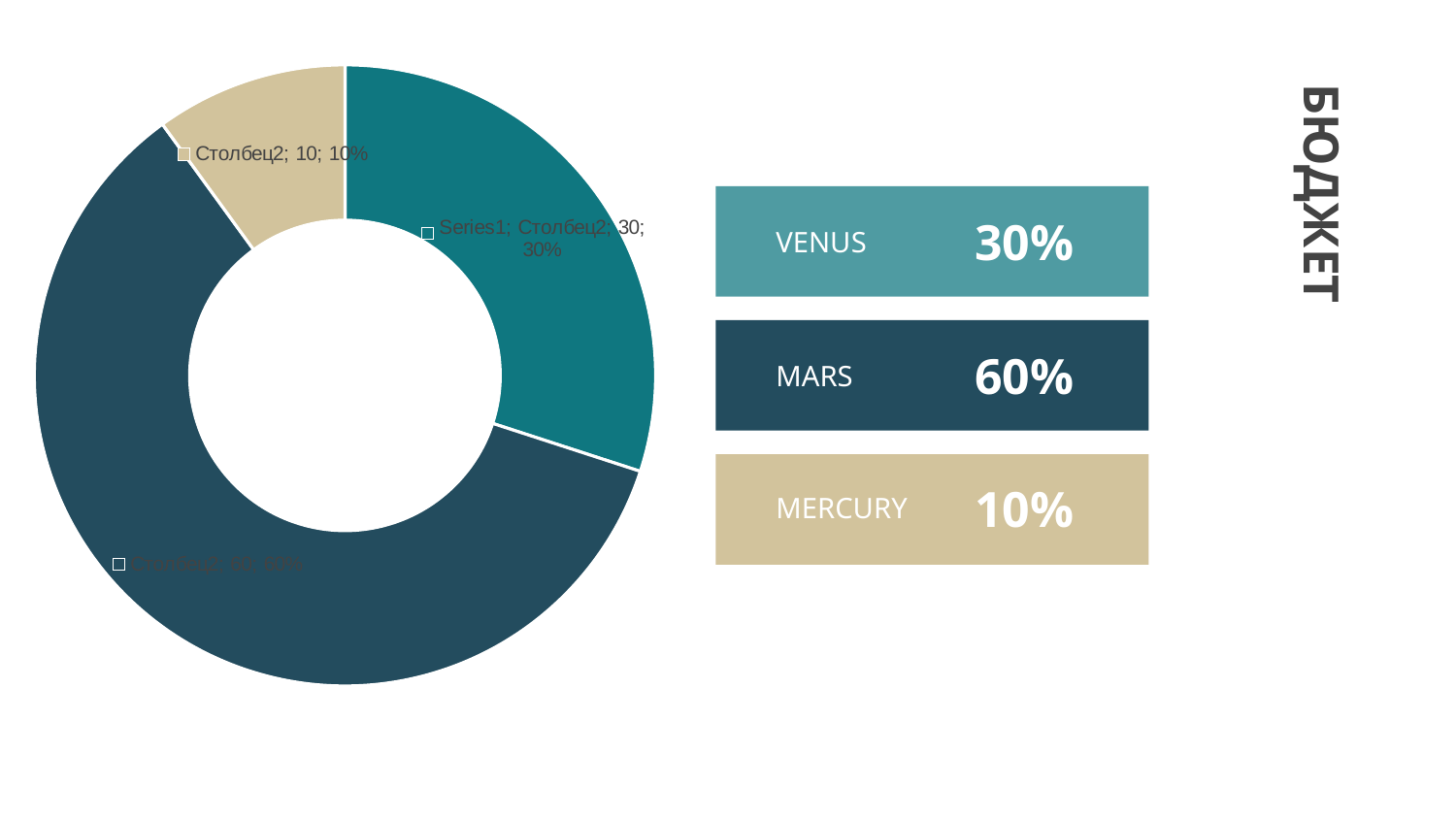
What is the combined share of Venus and Mercury? 40% What share of the budget does Venus have? 30% What is the difference in percentage points between the Mars share and the Venus share? 30 What share of the budget does Mercury have? 10% Which is larger, the share for Venus or the share for Mercury? Venus How many slices does the doughnut chart have? 3 Which category has the largest share of the doughnut chart? Mars What colour is the Mars slice of the doughnut chart? dark blue What is the title shown on the slide? БЮДЖЕТ What share of the budget does Mars have? 60% What kind of chart is shown on the slide? doughnut chart Which category has the smallest share of the doughnut chart? Mercury